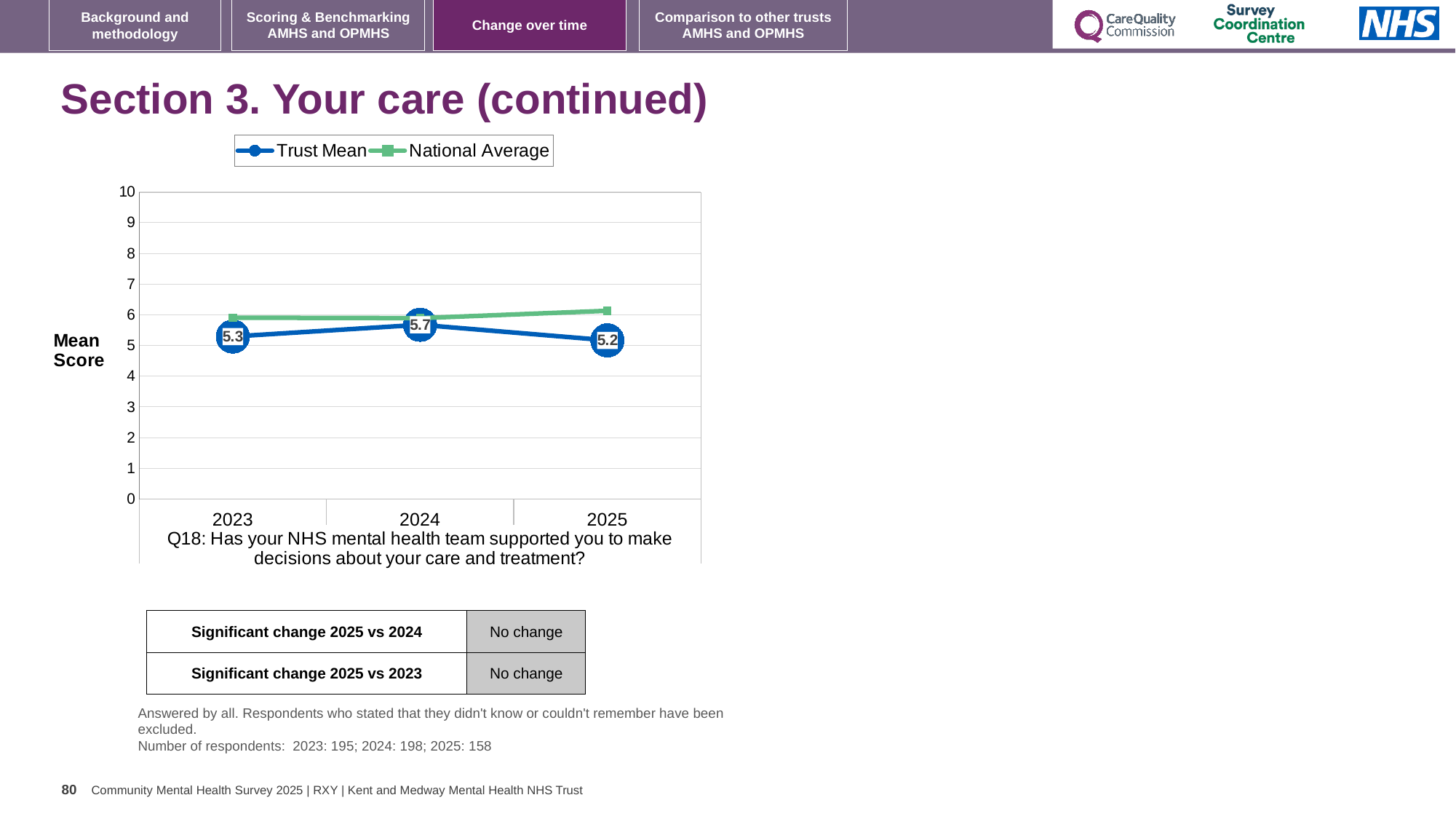
What is the Trust Mean score for 2025? 5.2 Does the Trust Mean rise or fall from 2024 to 2025? Fall What is the Trust Mean score for 2023? 5.3 In which year was the Trust Mean highest? 2024 In which year was the Trust Mean lowest? 2025 In 2025, which is larger: the Trust Mean or the National Average? National Average What kind of chart is shown on the slide? Line chart How many years are shown on the x axis? 3 What is the difference between the Trust Mean in 2024 and in 2025? 0.5 What is the Trust Mean score for 2024? 5.7 How many series does the legend list? 2 Is the National Average value for 2025 greater or less than 5? greater